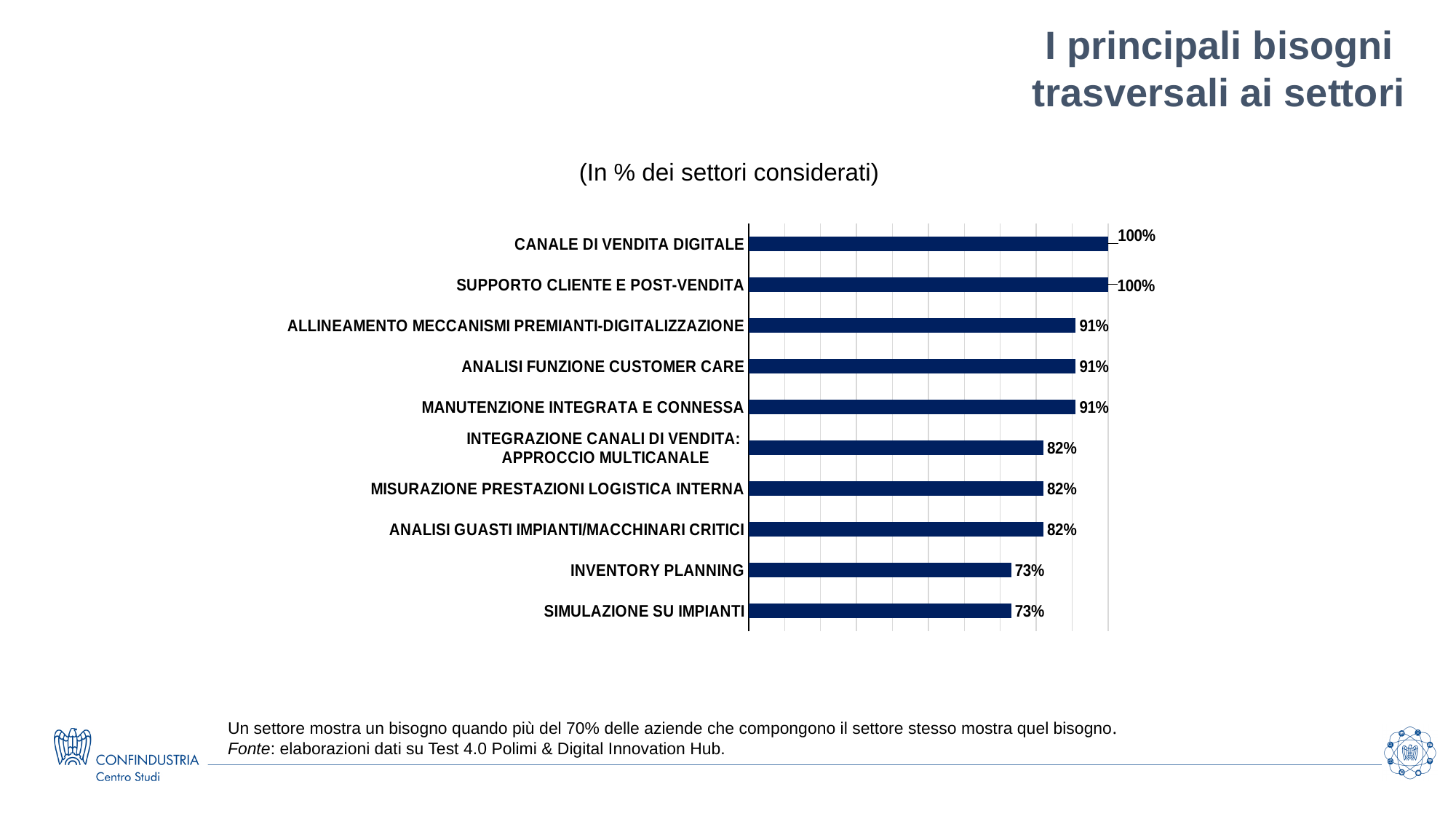
What is the value for MISURAZIONE PRESTAZIONI LOGISTICA INTERNA? 82% How many categories have a value of 82%? 3 How many categories are shown in the chart? 10 What is the difference between the value for SUPPORTO CLIENTE E POST-VENDITA and the value for SIMULAZIONE SU IMPIANTI? 27% Which is larger: the value for ALLINEAMENTO MECCANISMI PREMIANTI-DIGITALIZZAZIONE or the value for INTEGRAZIONE CANALI DI VENDITA: APPROCCIO MULTICANALE? ALLINEAMENTO MECCANISMI PREMIANTI-DIGITALIZZAZIONE Which categories have the lowest value in the chart? INVENTORY PLANNING and SIMULAZIONE SU IMPIANTI What is the subtitle shown above the chart? (In % dei settori considerati) What is the difference between the value for ANALISI FUNZIONE CUSTOMER CARE and the value for ANALISI GUASTI IMPIANTI/MACCHINARI CRITICI? 9% What is the value for CANALE DI VENDITA DIGITALE? 100% What kind of chart is shown on the slide? Bar chart What is the value for MANUTENZIONE INTEGRATA E CONNESSA? 91% What is the value for INVENTORY PLANNING? 73%